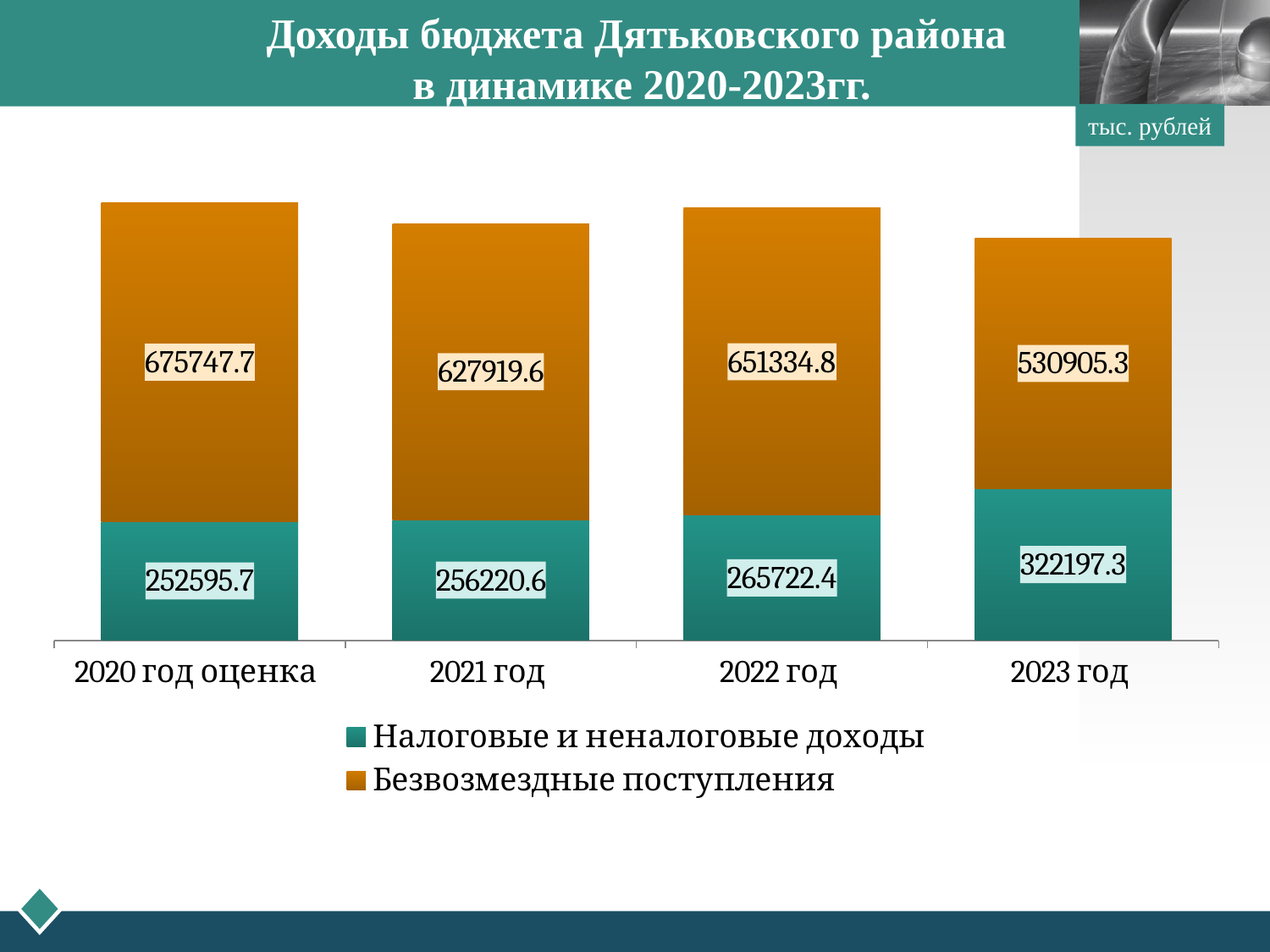
What unit of measurement is indicated on the slide? тыс. рублей What is the value of Безвозмездные поступления for 2021 год? 627919.6 Which year has the lowest value of Безвозмездные поступления? 2023 год How many series does the legend list? 2 What kind of chart is shown on the slide? Stacked bar chart What is the difference between Налоговые и неналоговые доходы in 2023 год and in 2020 год оценка? 69601.6 Which is larger: Безвозмездные поступления in 2022 год or in 2021 год? 2022 год What is the value of Безвозмездные поступления for 2023 год? 530905.3 Which year has the highest value of Налоговые и неналоговые доходы? 2023 год How many years are shown on the x axis? 4 What is the total of the stacked bar for 2023 год? 853102.6 What is the value of Налоговые и неналоговые доходы for 2020 год оценка? 252595.7